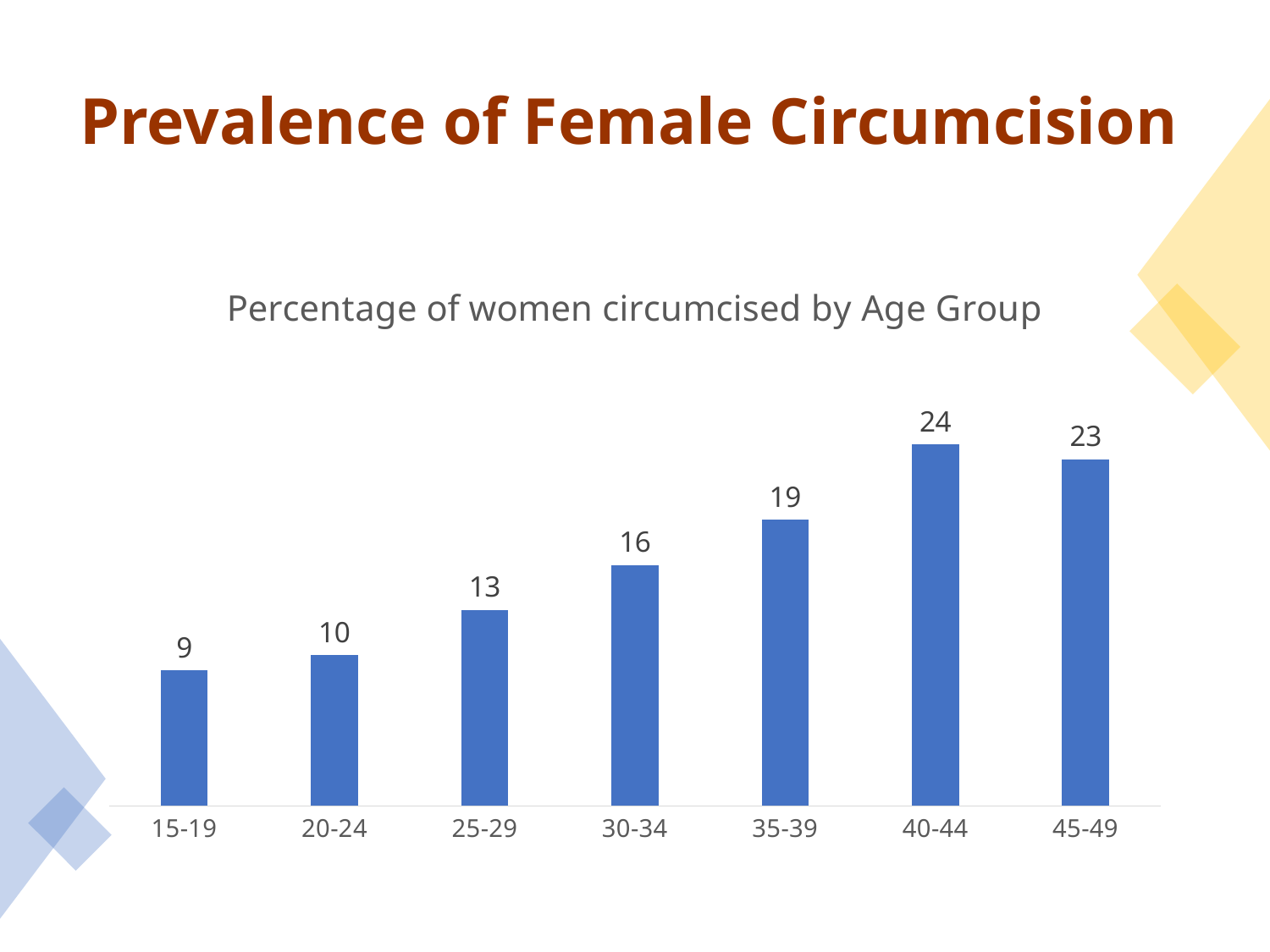
Do the values generally rise or fall from the 15-19 group to the 40-44 group? rise How many age groups are shown on the chart? 7 What is the value for the 45-49 age group? 23 What is the difference between the values for 40-44 and 15-19? 15 What is the difference between the values for 35-39 and 25-29? 6 Which is larger, the value for 20-24 or the value for 30-34? 30-34 What kind of chart is shown on the slide? bar chart What is the value for the 30-34 age group? 16 What is the value for the 15-19 age group? 9 What is the title of the chart? Percentage of women circumcised by Age Group Which age group has the highest value? 40-44 Which age group has the lowest value? 15-19